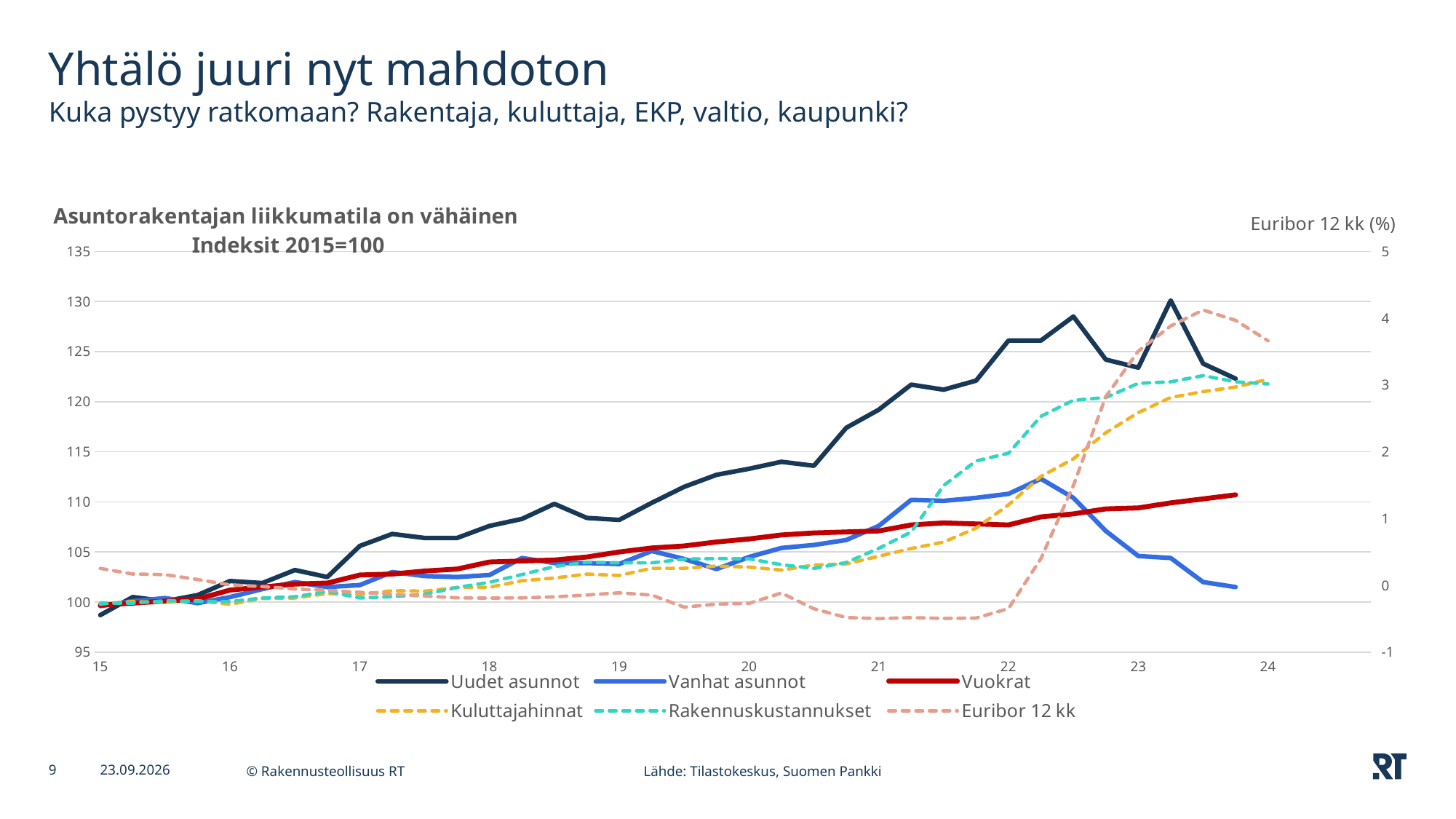
Is the value for Vuokrat at 22 greater or less than 110? less Is the value for Euribor 12 kk at 22 greater or less than 0 on the right axis? less Does the Vanhat asunnot line rise or fall between 22 and 24? fall At 22, which is larger: Rakennuskustannukset or Kuluttajahinnat? Rakennuskustannukset What is the label of the right-hand vertical axis? Euribor 12 kk (%) How many series does the legend list? 6 Is the value for Uudet asunnot at 22.5 greater or less than 125? greater What kind of chart is shown on the slide? line chart Which series reaches the highest index value on the left axis? Uudet asunnot What is the title of the chart? Asuntorakentajan liikkumatila on vähäinen Indeksit 2015=100